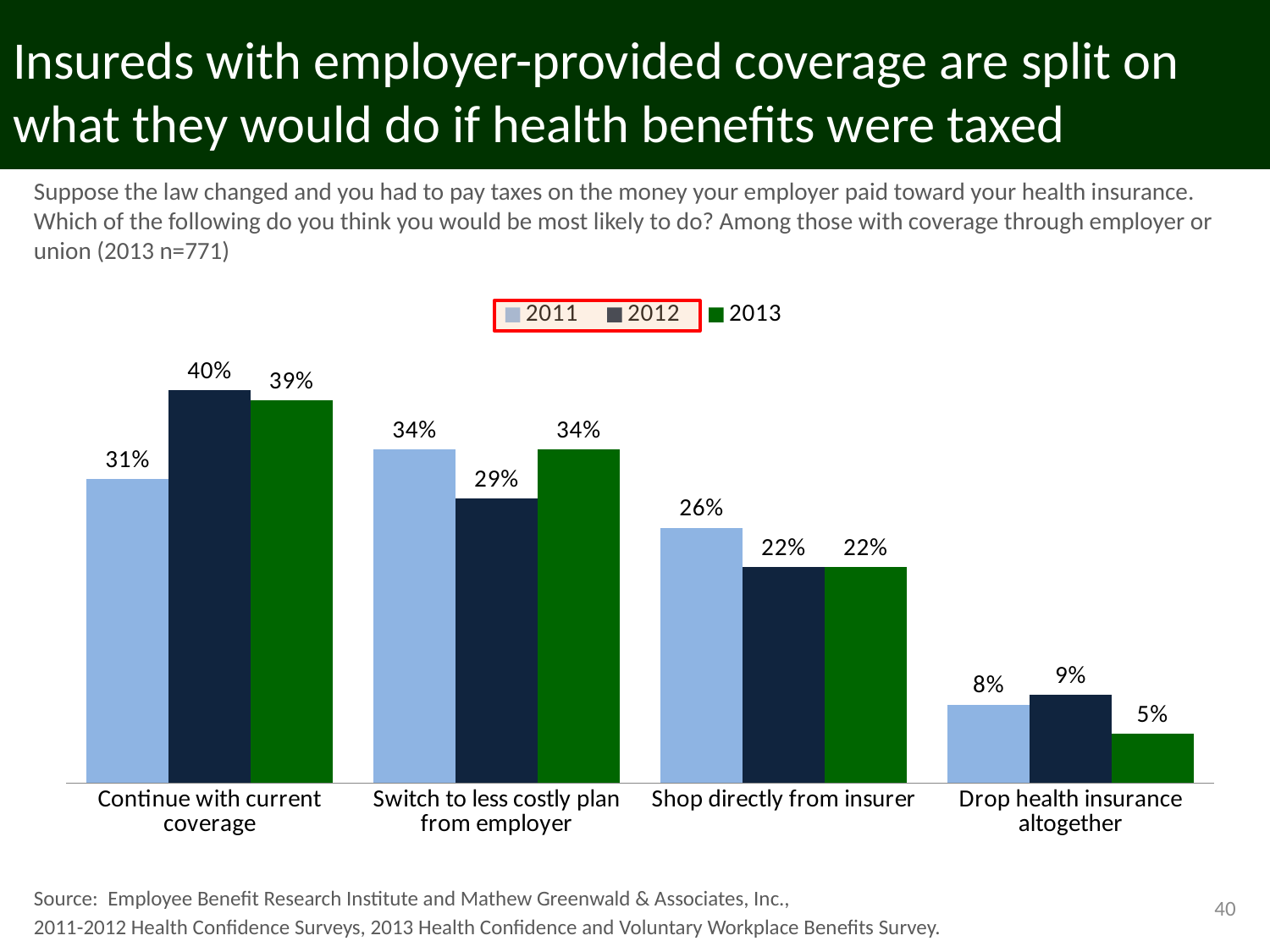
Which years are listed in the chart's legend? 2011, 2012, 2013 Do the 2013 values rise or fall moving from left to right across the categories? Fall What percentage in 2012 said they would drop health insurance altogether? 9% What was the 2011 value for 'Shop directly from insurer'? 26% Which category had the lowest value in 2013? Drop health insurance altogether What kind of chart is shown on the slide? Bar chart How many response categories are shown on the x axis? 4 How many series does the legend list? 3 What is the difference between the 2012 and 2011 values for 'Continue with current coverage'? 9 percentage points Which category had the highest value in 2012? Continue with current coverage Which is larger for 'Switch to less costly plan from employer': the 2011 value or the 2012 value? 2011 What percentage of respondents in 2013 said they would continue with current coverage? 39%